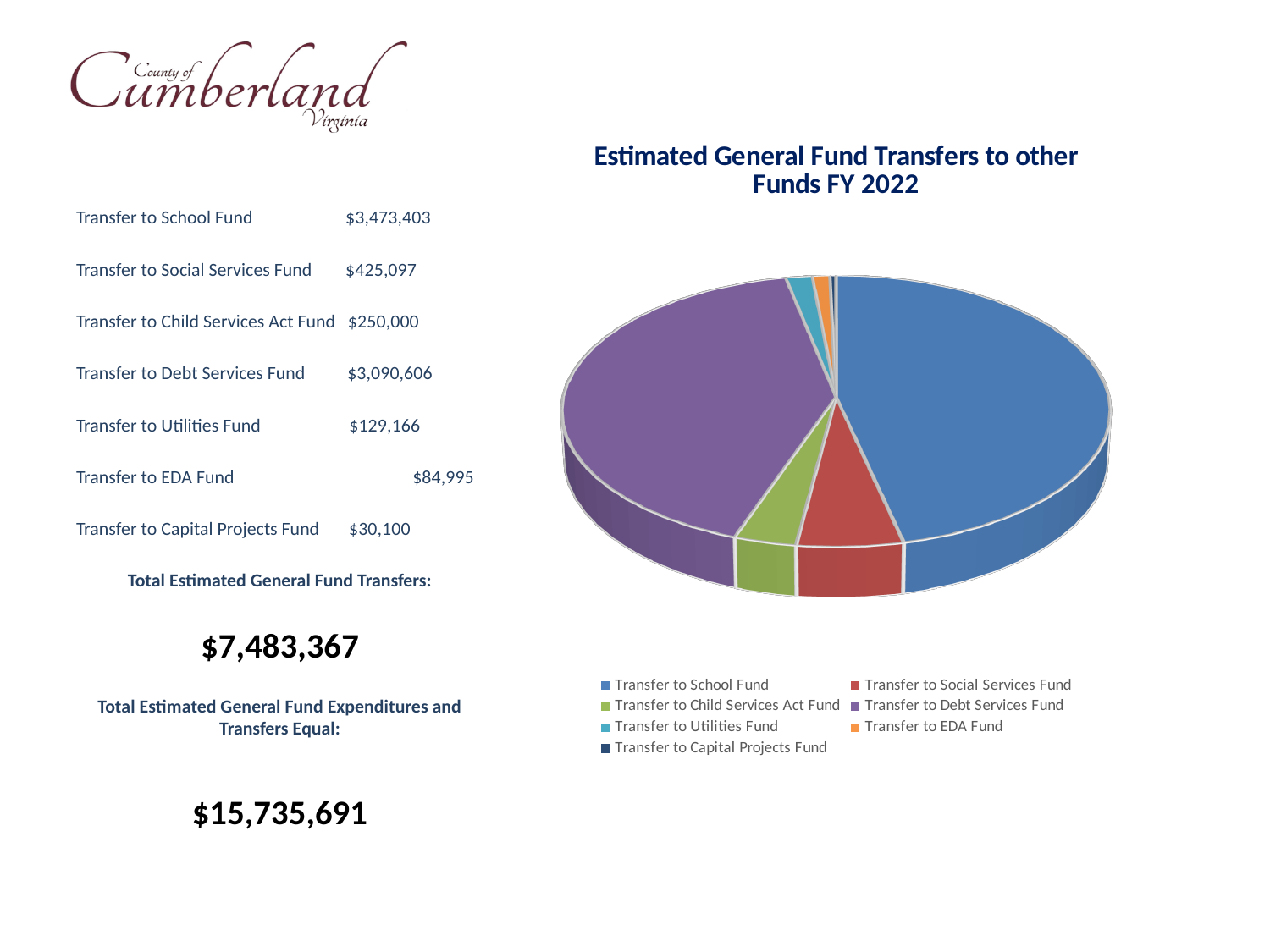
How many slices does the pie chart have? 7 What is the value of the Transfer to Utilities Fund? $129,166 What kind of chart is shown on the slide? Pie chart How many entries does the chart legend list? 7 Which is larger, the Transfer to School Fund or the Transfer to Debt Services Fund? Transfer to School Fund Which fund receives the largest transfer in the pie chart? Transfer to School Fund What is the value of the Transfer to Debt Services Fund? $3,090,606 What is the total of all the transfers shown in the pie chart? $7,483,367 Which fund receives the smallest transfer in the pie chart? Transfer to Capital Projects Fund What is the title of the chart? Estimated General Fund Transfers to other Funds FY 2022 What colour is the Transfer to Debt Services Fund slice? Purple What is the difference between the Transfer to School Fund and the Transfer to Debt Services Fund? $382,797